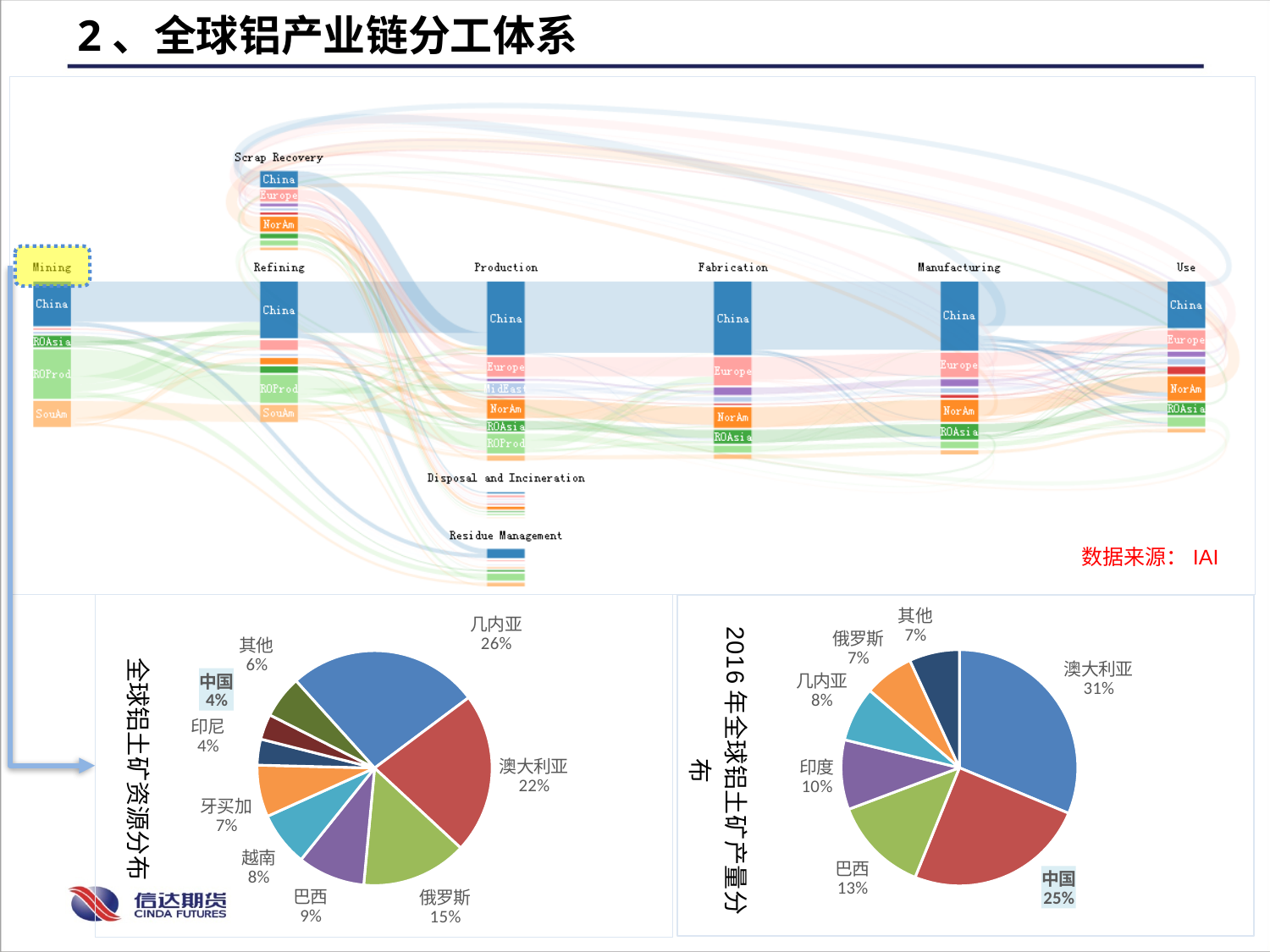
In the pie chart titled 全球铝土矿资源分布, what share does 几内亚 have? 26% In the pie chart titled 2016年全球铝土矿产量分布, what share does 澳大利亚 have? 31% In the pie chart titled 全球铝土矿资源分布, which country has the largest share? 几内亚 What type of chart is used for 2016年全球铝土矿产量分布 at the bottom right of the slide? Pie chart In the pie chart titled 2016年全球铝土矿产量分布, which country has the largest share? 澳大利亚 In the pie chart titled 2016年全球铝土矿产量分布, how many slices are shown? 7 In the pie chart titled 全球铝土矿资源分布, what share does 中国 have? 4% In the pie chart titled 2016年全球铝土矿产量分布, what share does 中国 have? 25% In the pie chart titled 全球铝土矿资源分布, what is the difference between the shares of 澳大利亚 and 俄罗斯? 7% In the pie chart titled 全球铝土矿资源分布, how many slices are shown? 9 In the pie chart titled 全球铝土矿资源分布, which is larger, the share of 巴西 or the share of 越南? 巴西 In the pie chart titled 2016年全球铝土矿产量分布, what is the difference between the shares of 中国 and 巴西? 12%